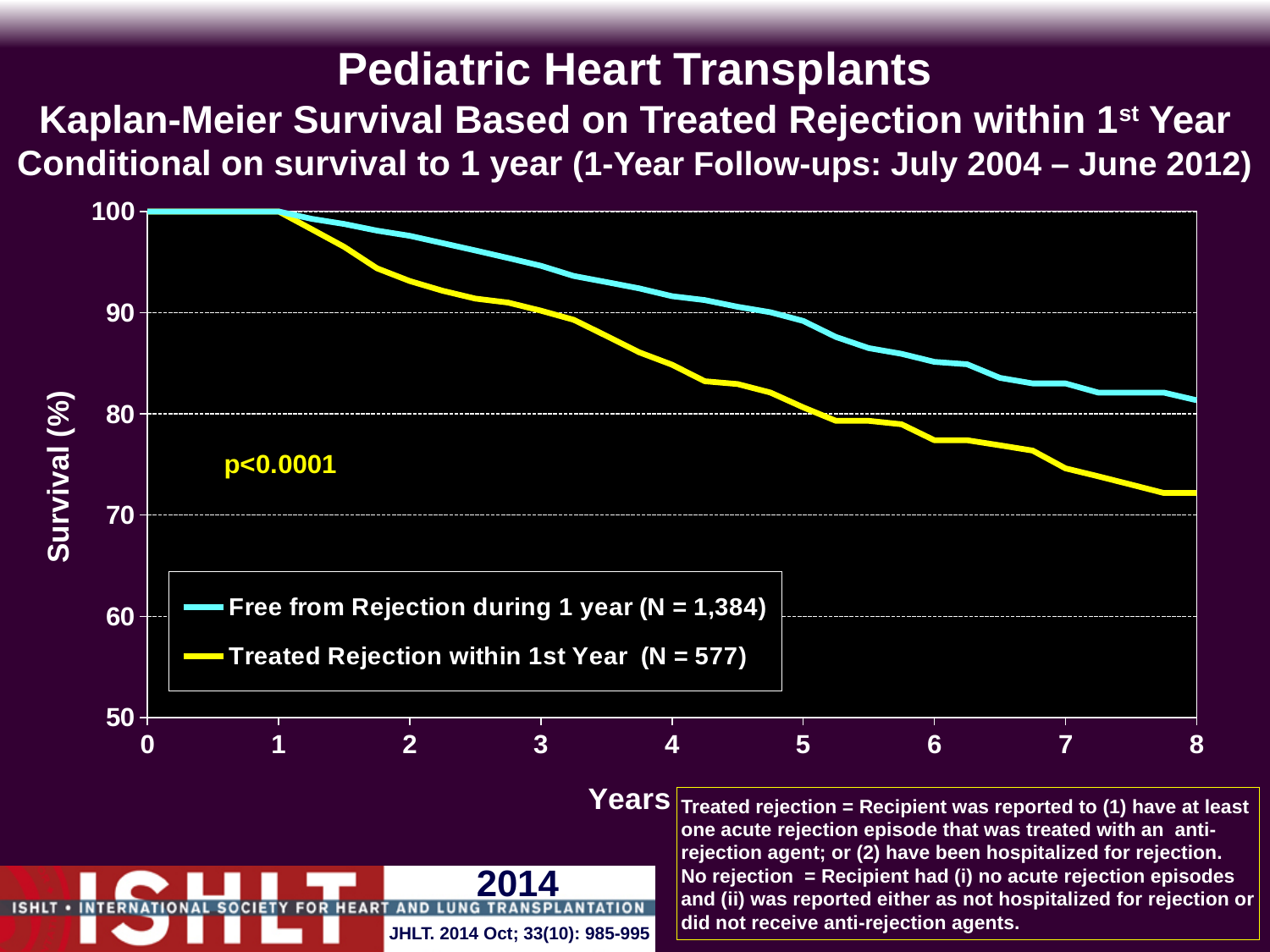
Do the survival curves rise or fall as years increase? Fall Is the survival for 'Free from Rejection during 1 year' at 4 years greater or less than 90? greater Is the survival for 'Treated Rejection within 1st Year' at 8 years greater or less than 70? greater How many series does the legend list? 2 Is the survival for 'Treated Rejection within 1st Year' at 6 years greater or less than 80? less What is the N for the 'Free from Rejection during 1 year' group shown in the legend? 1,384 What p-value is printed on the chart? p<0.0001 What kind of chart is shown on the slide? Line chart Which group has higher survival at 8 years, 'Free from Rejection during 1 year' or 'Treated Rejection within 1st Year'? Free from Rejection during 1 year What is the N for the 'Treated Rejection within 1st Year' group shown in the legend? 577 What is the label of the y axis? Survival (%)